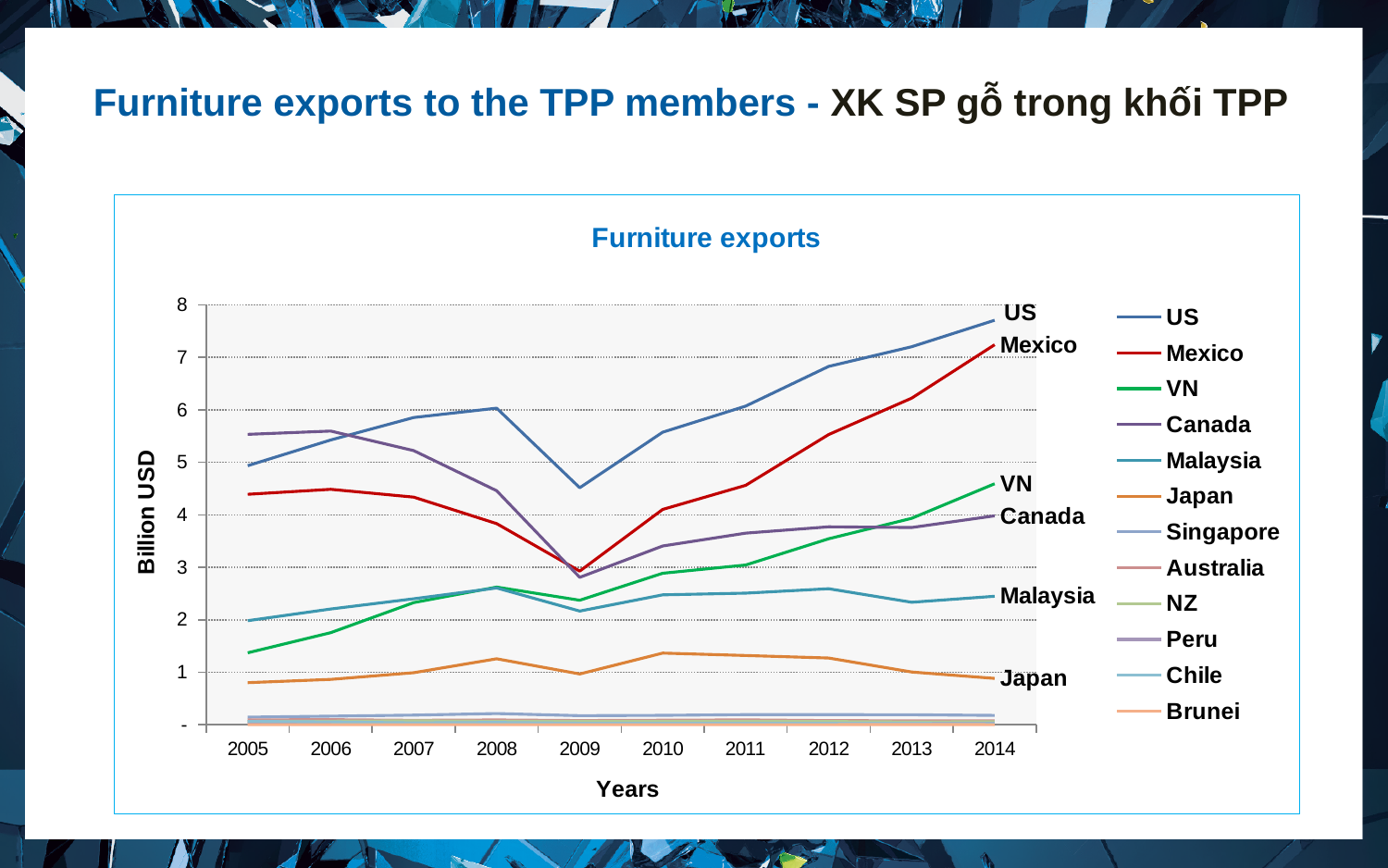
How many series does the legend of the Furniture exports chart list? 12 In 2014, which is larger: the value for VN or the value for Canada? VN How many years are shown on the x axis of the Furniture exports chart? 10 Which country has the highest furniture exports in 2014? US Is the value for Malaysia in 2014 greater or less than 3? less Is the value for VN in 2005 greater or less than 2? less What type of chart is shown on the slide? line chart Is the value for Mexico in 2009 greater or less than 4? less What is the title of the vertical axis of the chart? Billion USD In 2005, which is larger: the value for Canada or the value for US? Canada Do the values for Mexico rise or fall from 2009 to 2014? rise